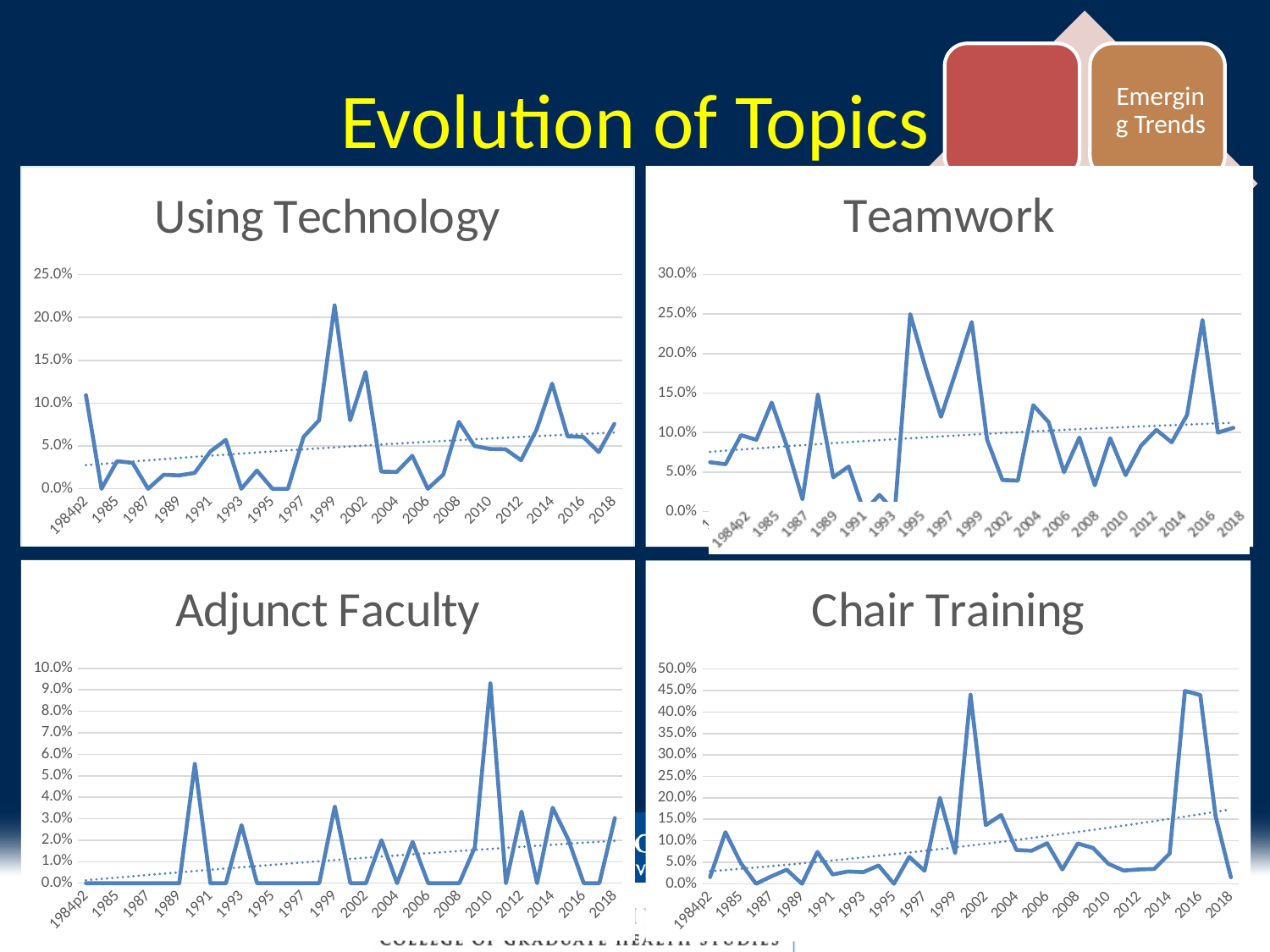
What kind of chart is the Using Technology chart? line chart In the Using Technology chart, which year has the highest value? 1999 In the Chair Training chart, does the dotted trend line rise or fall from 1984 to 2018? rise In the Adjunct Faculty chart, is the value for 2010 greater or less than 8.0%? greater In the Adjunct Faculty chart, which year has the highest value? 2010 How many charts are shown on the slide? 4 In the Using Technology chart, is the value for 1999 greater or less than 15.0%? greater In the Chair Training chart, is the value for 2016 greater or less than 40.0%? greater